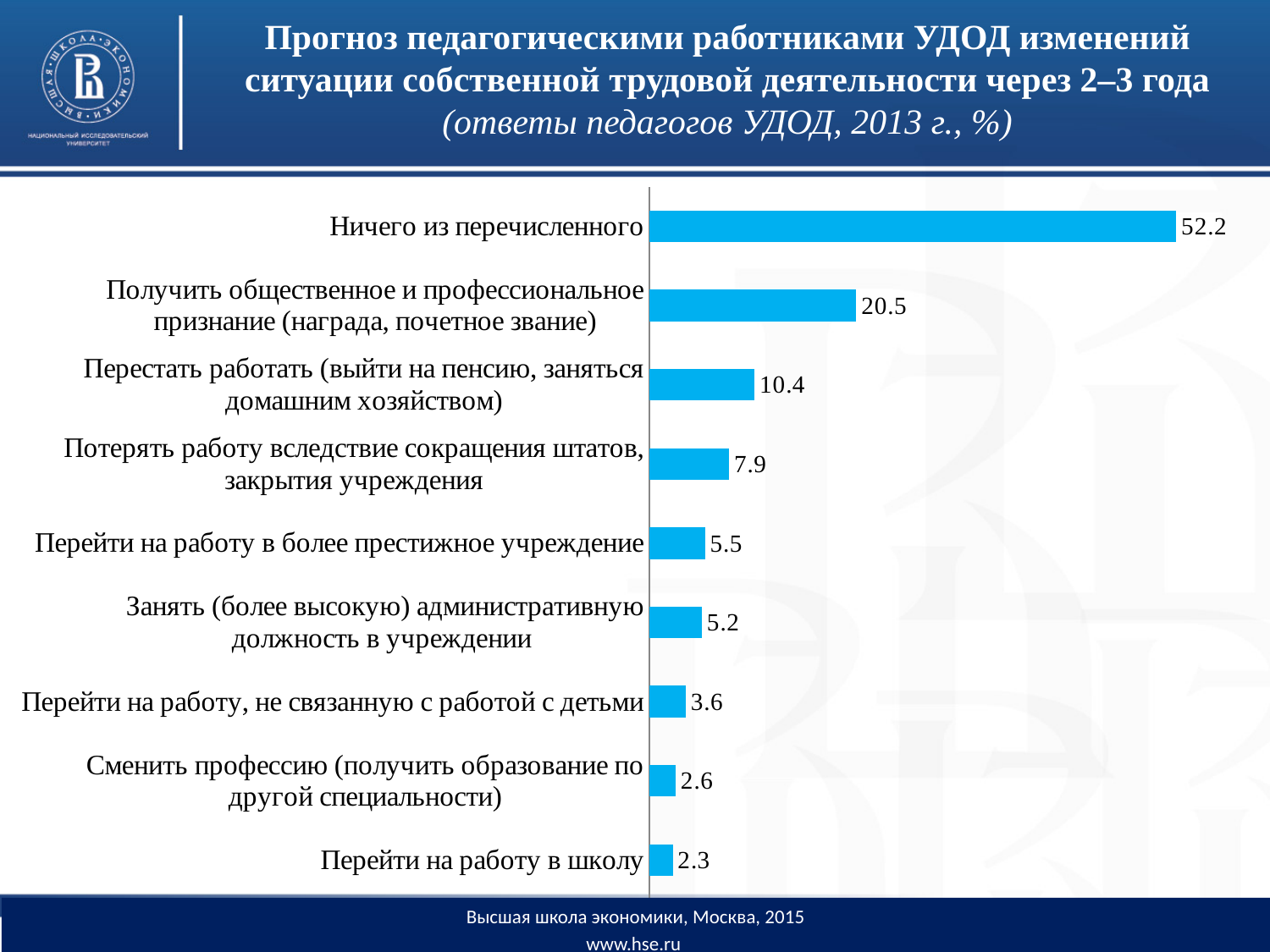
Which is larger: the value for "Перестать работать (выйти на пенсию, заняться домашним хозяйством)" or the value for "Потерять работу вследствие сокращения штатов, закрытия учреждения"? Перестать работать (выйти на пенсию, заняться домашним хозяйством) What is the value for "Потерять работу вследствие сокращения штатов, закрытия учреждения"? 7.9 What is the value for "Перейти на работу в школу"? 2.3 What is the value for "Перестать работать (выйти на пенсию, заняться домашним хозяйством)"? 10.4 What is the value for "Ничего из перечисленного"? 52.2 How many categories are shown in the chart? 9 Which category has the highest value? Ничего из перечисленного What year do the responses in the chart refer to, according to the title? 2013 What is the difference between the values for "Перейти на работу, не связанную с работой с детьми" and "Сменить профессию (получить образование по другой специальности)"? 1.0 What kind of chart is shown on the slide? Bar chart What is the difference between the values for "Ничего из перечисленного" and "Получить общественное и профессиональное признание (награда, почетное звание)"? 31.7 Which category has the lowest value? Перейти на работу в школу